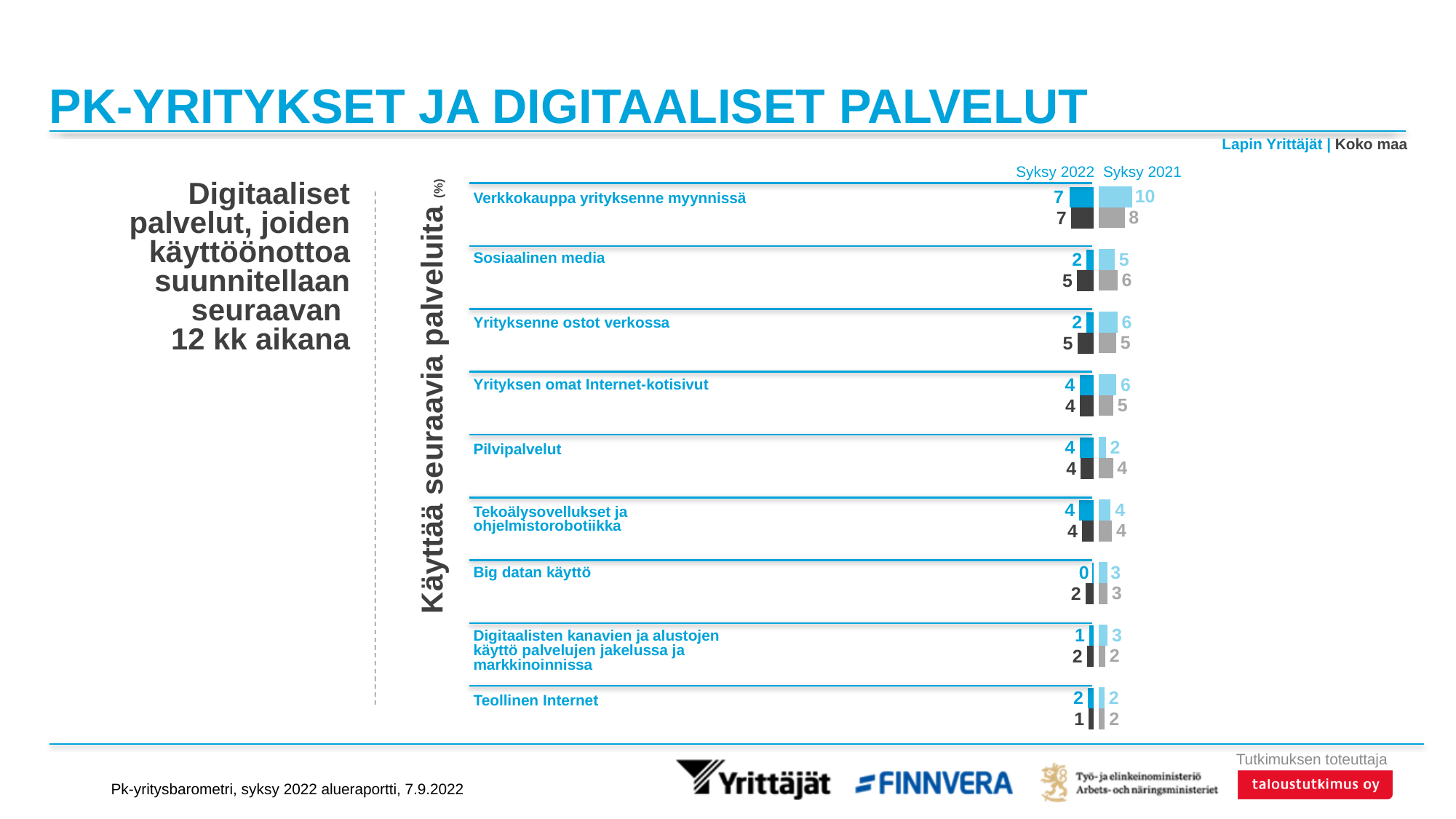
What is the difference between the Lapin Yrittäjät Syksy 2021 and Syksy 2022 values for "Yrityksenne ostot verkossa"? 4 How many digital service categories are listed in the chart? 9 How many time periods are shown as column headings in the chart? 2 Which category has the lowest Lapin Yrittäjät value for Syksy 2022? Big datan käyttö For "Pilvipalvelut", which is larger for Lapin Yrittäjät: the Syksy 2022 value or the Syksy 2021 value? Syksy 2022 What kind of chart is shown on the slide? Bar chart What is the Lapin Yrittäjät value for Syksy 2022 for "Big datan käyttö"? 0 What is the Koko maa value for Syksy 2022 for "Sosiaalinen media"? 5 Which category has the highest Lapin Yrittäjät value for Syksy 2021? Verkkokauppa yrityksenne myynnissä What is the Koko maa value for Syksy 2021 for "Teollinen Internet"? 2 What is the Lapin Yrittäjät value for Syksy 2021 for "Verkkokauppa yrityksenne myynnissä"? 10 What is the Lapin Yrittäjät value for Syksy 2022 for "Verkkokauppa yrityksenne myynnissä"? 7